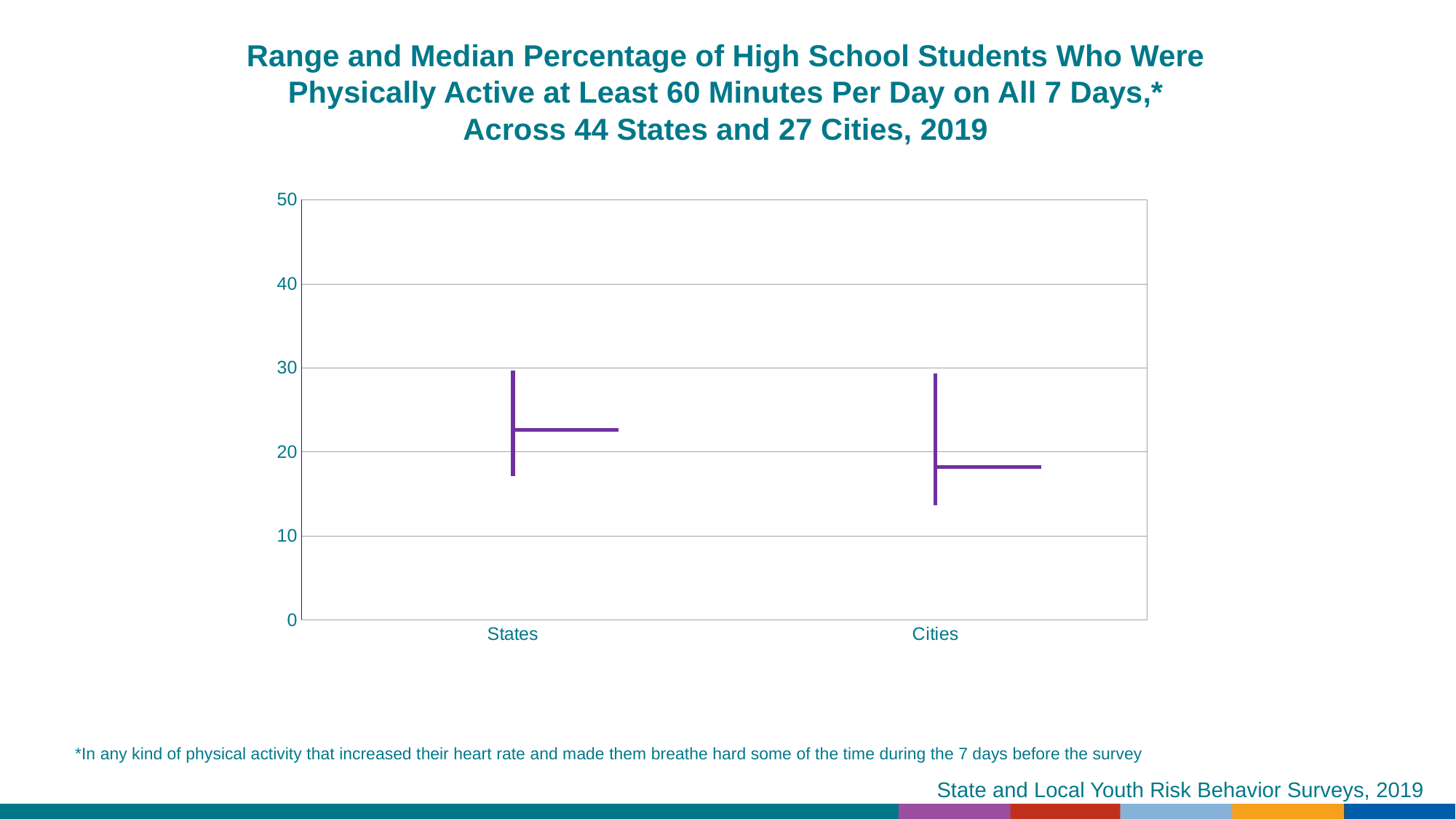
Is the highest value in the range for Cities greater or less than 20? greater Is the lowest value in the range for Cities greater or less than 20? less How many categories are shown on the x axis of the chart? 2 Which category has the lower bottom of its range, States or Cities? Cities Is the lowest value in the range for States greater or less than 10? greater Which category has the higher median percentage, States or Cities? States What are the two categories shown on the x axis? States and Cities Does the median percentage rise or fall from States to Cities? fall What is the maximum value shown on the y axis? 50